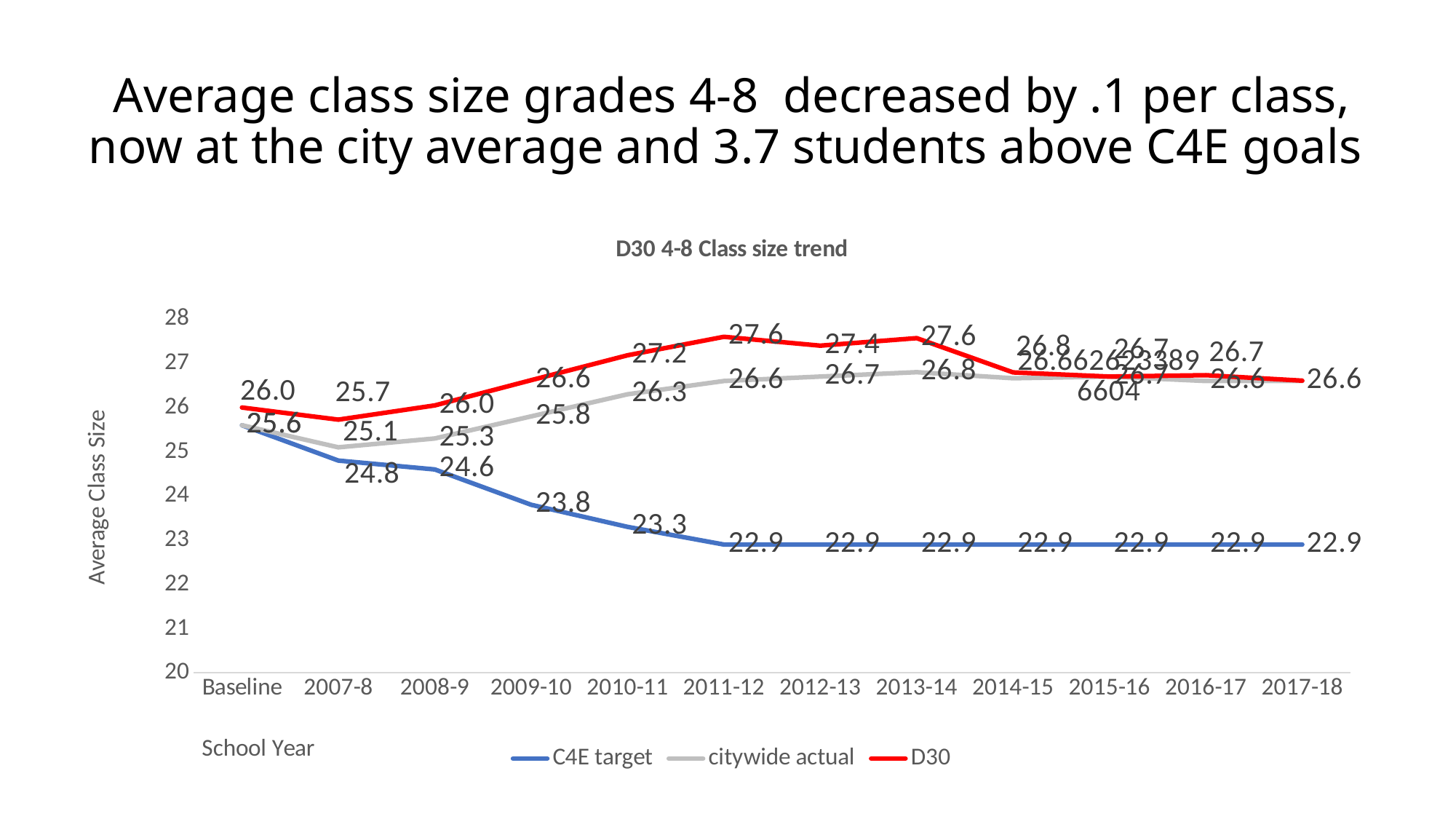
What kind of chart is shown on the slide? line chart What is the C4E target value for 2009-10? 23.8 What is the C4E target value for 2008-9? 24.6 What is the citywide actual value for 2012-13? 26.7 In which school year is the D30 value lowest? 2007-8 Which is larger in 2011-12, the D30 value or the citywide actual value? D30 Is the citywide actual value for 2014-15 greater or less than 26? greater What is the difference between the D30 value and the C4E target value in 2017-18? 3.7 How many school years are plotted along the x axis? 12 What is the title of the chart? D30 4-8 Class size trend How many series does the legend list? 3 What is the D30 value for 2011-12? 27.6